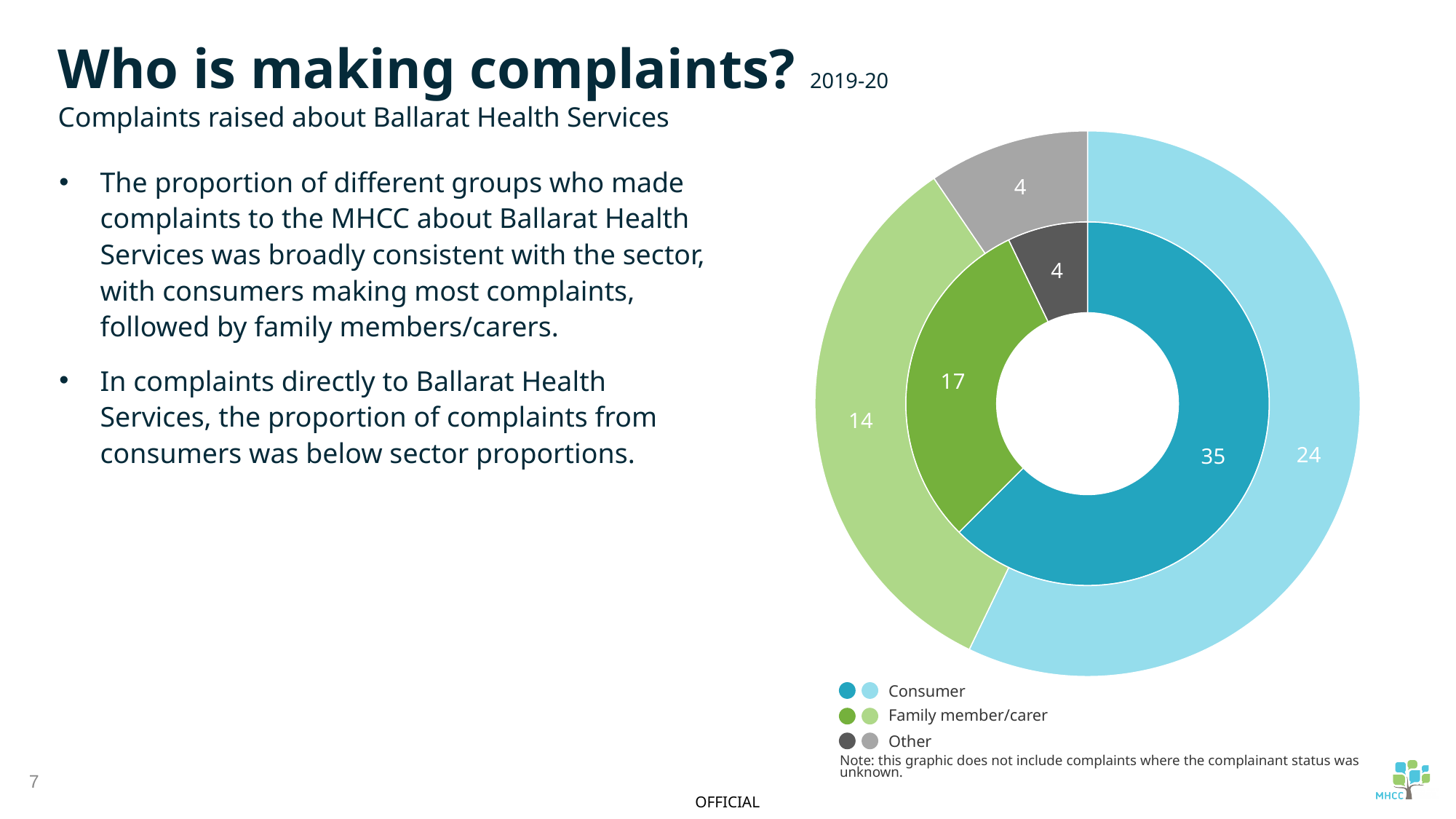
In the outer ring of the doughnut chart, what is the value for Consumer? 24 What kind of chart is shown on the slide? doughnut chart In the inner ring of the doughnut chart, what is the value for Consumer? 35 How many categories does the chart legend list? 3 In the inner ring of the doughnut chart, what is the value for Family member/carer? 17 Which category has the largest value in the inner ring of the doughnut chart? Consumer In the outer ring of the doughnut chart, what is the value for Other? 4 In the outer ring of the doughnut chart, what is the value for Family member/carer? 14 Which category has the smallest value in the outer ring of the doughnut chart? Other In the outer ring, which is larger: the Consumer value or the Family member/carer value? Consumer In the inner ring, what is the difference between the Consumer value and the Family member/carer value? 18 What is the total of the values in the inner ring of the doughnut chart? 56